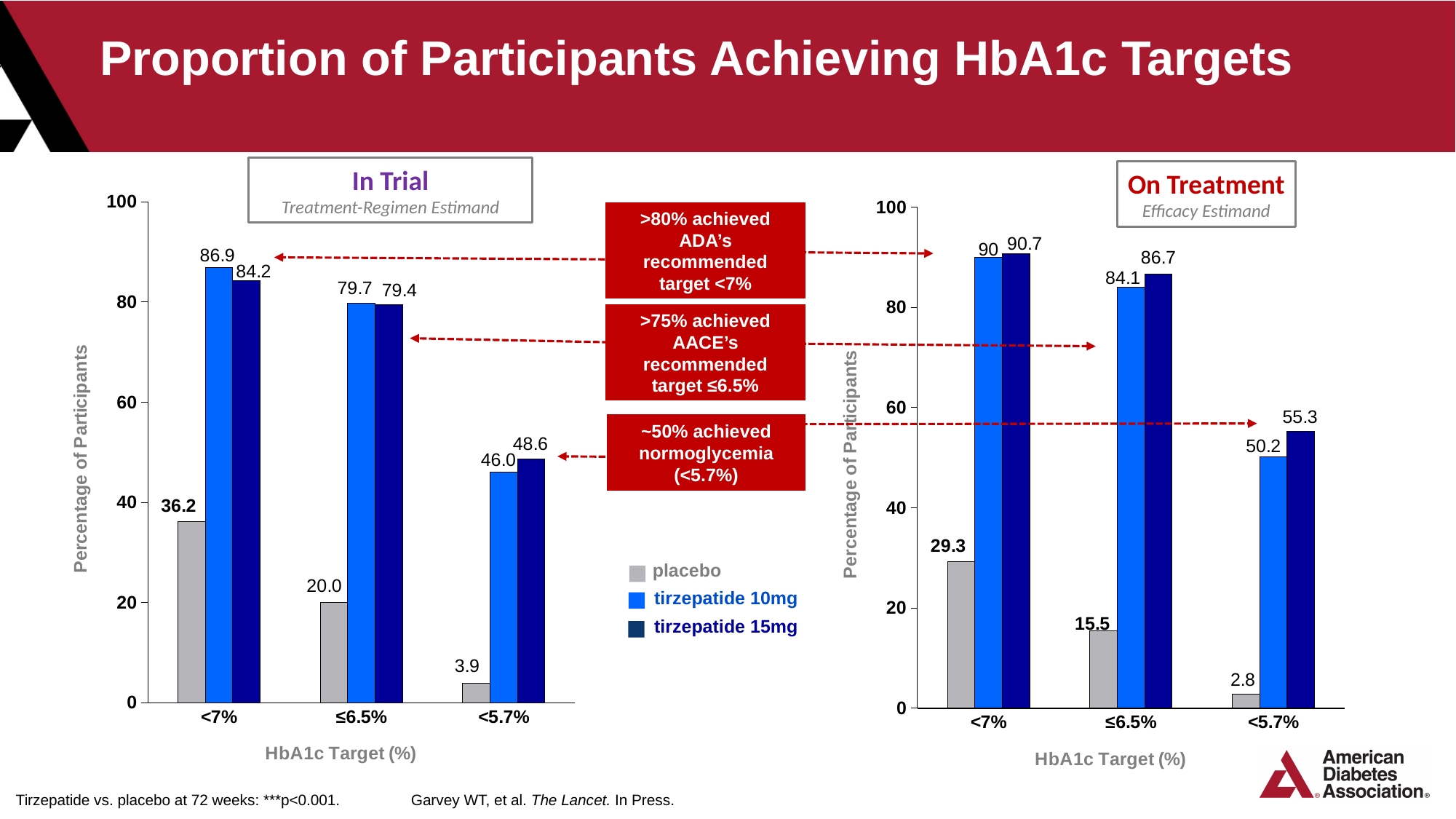
In the On Treatment chart, what is the value for placebo at the ≤6.5% target? 15.5 In the In Trial chart, what is the difference between tirzepatide 10mg and placebo at the <7% target? 50.7 In the In Trial chart, what is the value for placebo at the <7% target? 36.2 What kind of chart is the In Trial chart? bar chart How many series does the legend list? 3 In the On Treatment chart, what is the value for tirzepatide 15mg at the <5.7% target? 55.3 In the In Trial chart, what is the value for tirzepatide 10mg at the ≤6.5% target? 79.7 In the On Treatment chart, which series has the highest value at the <7% target? tirzepatide 15mg In the On Treatment chart, what is the difference between tirzepatide 15mg and tirzepatide 10mg at the ≤6.5% target? 2.6 In the In Trial chart, which series has the lowest value at the <5.7% target? placebo In the In Trial chart, which is larger at the <5.7% target: tirzepatide 10mg or tirzepatide 15mg? tirzepatide 15mg How many HbA1c target categories are shown on the x axis of the On Treatment chart? 3